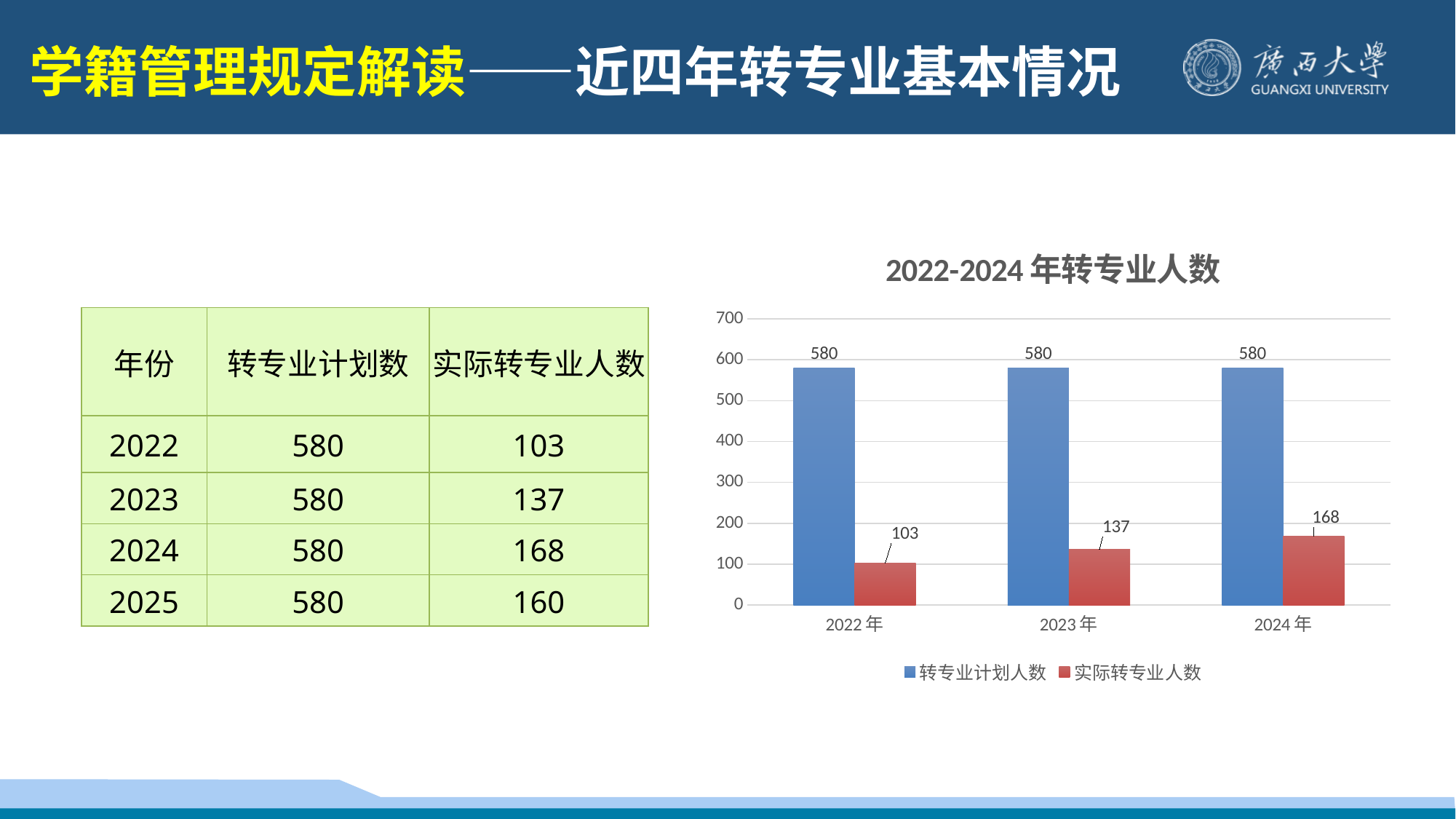
What is the difference between 转专业计划人数 and 实际转专业人数 in 2023年? 443 What is the value of 实际转专业人数 for 2024年? 168 By how much did 实际转专业人数 increase from 2022年 to 2024年? 65 How many years are shown on the x axis of the chart? 3 What kind of chart is shown on the slide? Bar chart Which is larger in 2024年, 转专业计划人数 or 实际转专业人数? 转专业计划人数 How many series does the chart legend list? 2 Does 实际转专业人数 rise or fall from 2022年 to 2024年? Rise Which year has the lowest 实际转专业人数? 2022年 What is the value of 转专业计划人数 for 2023年? 580 What is the value of 实际转专业人数 for 2022年? 103 Which year has the highest 实际转专业人数? 2024年